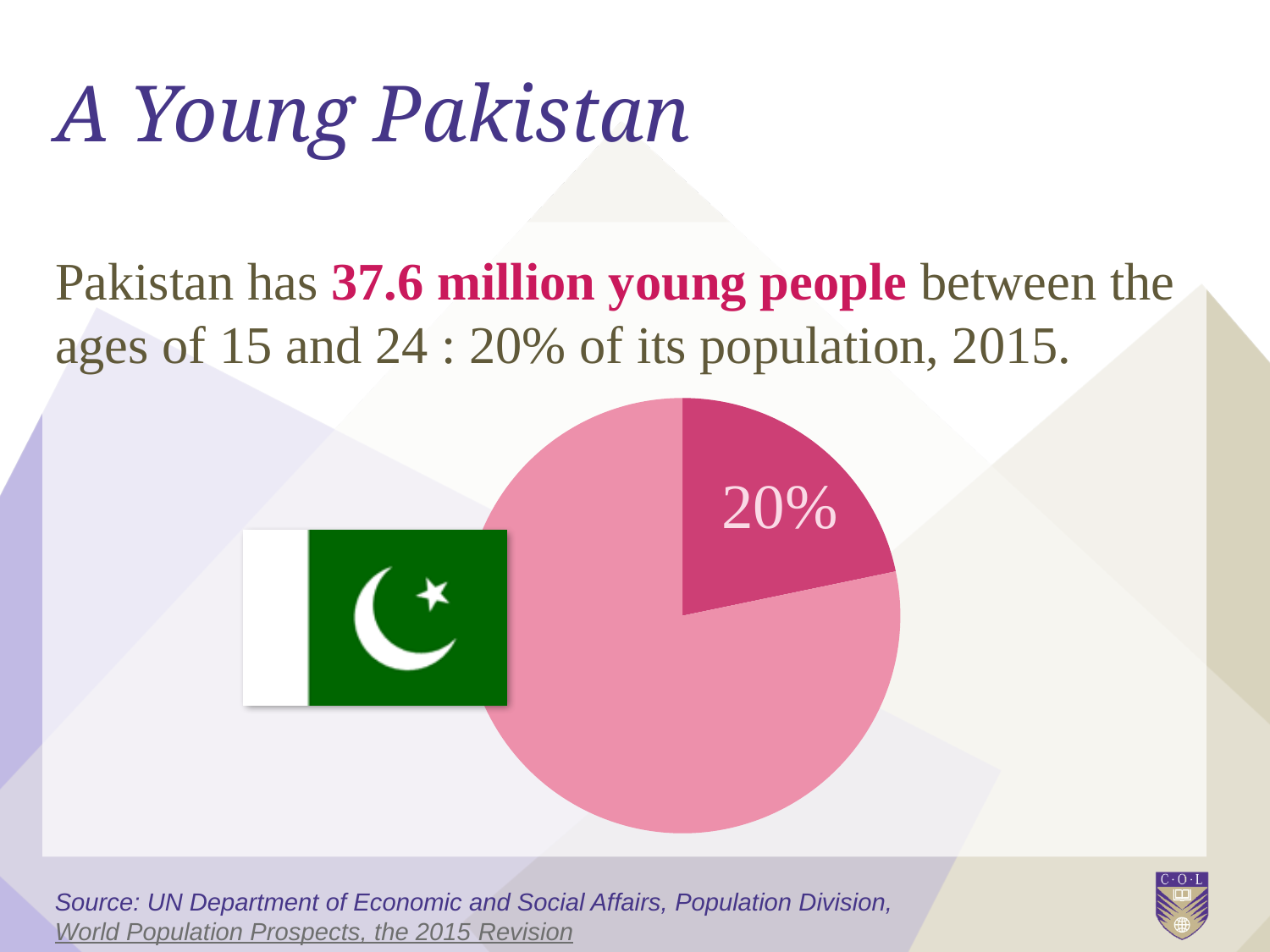
What kind of chart is shown on the slide? Pie chart What percentage is printed on the labelled slice of the pie chart? 20% What is the title of the slide containing the pie chart? A Young Pakistan How many young people between the ages of 15 and 24 does the slide say Pakistan has? 37.6 million How many slices does the pie chart have? 2 According to the slide, what does the 20% slice of the pie chart represent? Young people aged 15 to 24 as a share of Pakistan's population Which slice of the pie chart is larger, the labelled 20% slice or the unlabelled slice? The unlabelled slice